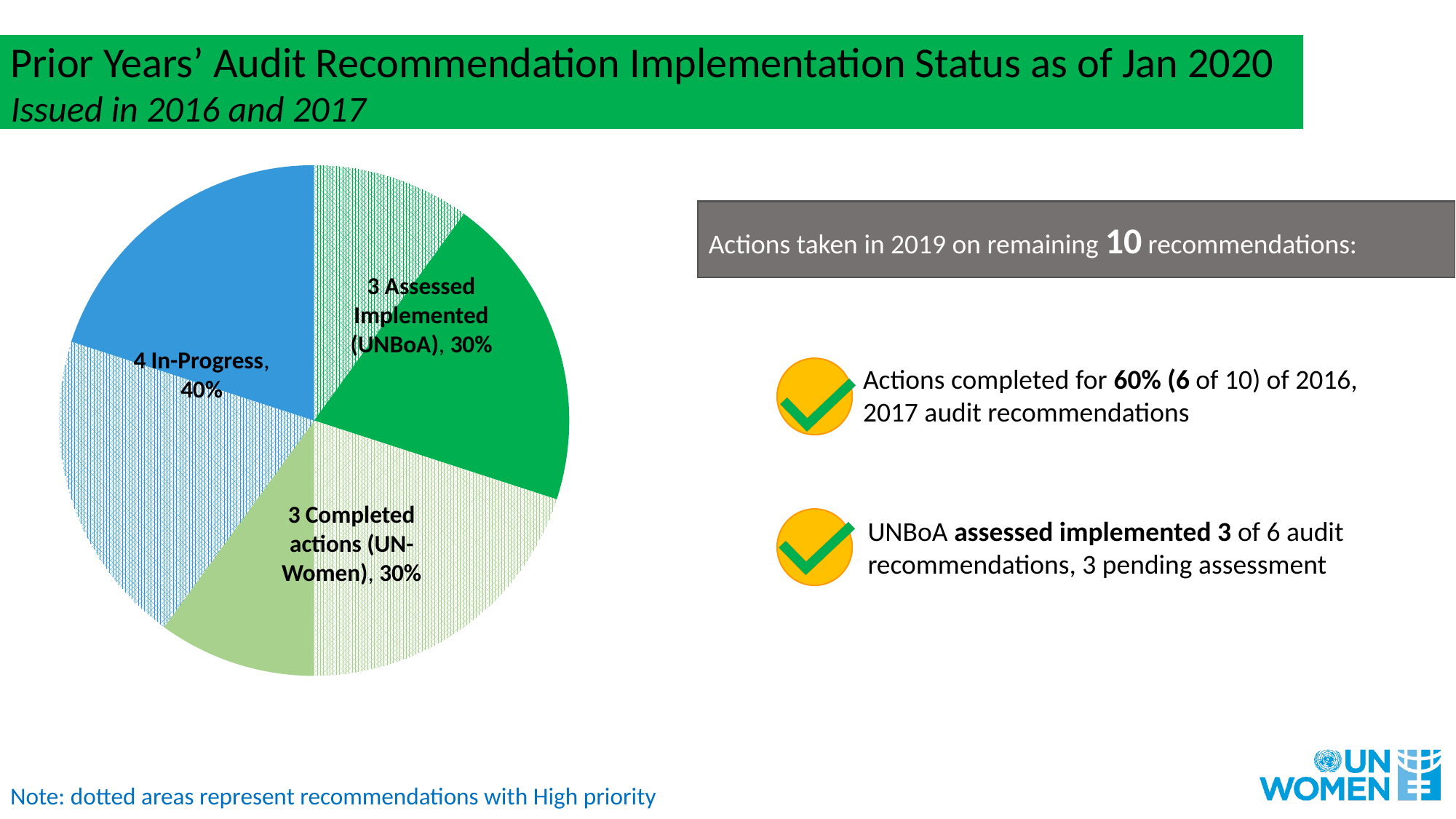
How many recommendations are labelled Assessed Implemented (UNBoA) in the pie chart? 3 Which slice of the pie chart is the largest? 4 In-Progress How many slices does the pie chart have? 6 What is the difference in percentage points between the In-Progress slice and the Completed actions (UN-Women) slice? 10 How many recommendations are In-Progress according to the pie chart label? 4 What kind of chart is shown on the slide? Pie chart What share of the pie is labelled Completed actions (UN-Women)? 30% Which is larger: the In-Progress share or the Assessed Implemented (UNBoA) share? In-Progress According to the note on the slide, what do the dotted areas of the pie chart represent? Recommendations with High priority What share of the pie is labelled In-Progress? 40% What share of the pie is labelled Assessed Implemented (UNBoA)? 30% What is the total number of recommendations represented across all slices of the pie chart? 10